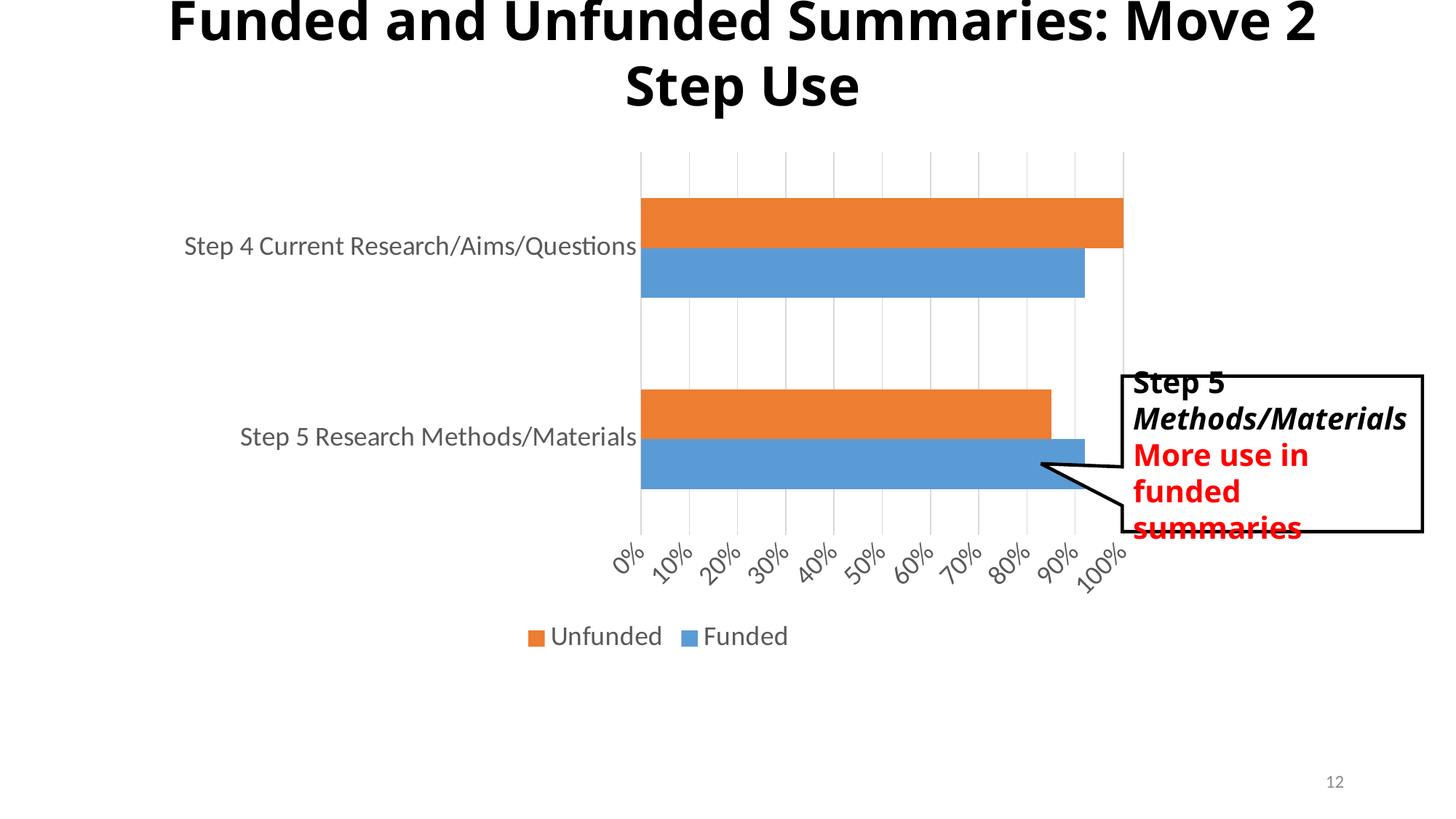
Is the Unfunded value for Step 5 Research Methods/Materials greater or less than 80%? greater What is the Unfunded value for Step 4 Current Research/Aims/Questions? 100% Which bar on the chart is the shortest? Unfunded for Step 5 Research Methods/Materials Which bar on the chart is the longest? Unfunded for Step 4 Current Research/Aims/Questions How many categories are plotted on the chart? 2 Which series has the higher value for Step 5 Research Methods/Materials, Unfunded or Funded? Funded Is the Funded value for Step 4 Current Research/Aims/Questions greater or less than 80%? greater How many series does the legend list? 2 Is the Unfunded value for Step 5 Research Methods/Materials greater or less than 90%? less Which series has the higher value for Step 4 Current Research/Aims/Questions, Unfunded or Funded? Unfunded What colour represents the Funded series in the legend? blue What kind of chart is shown on the slide? bar chart